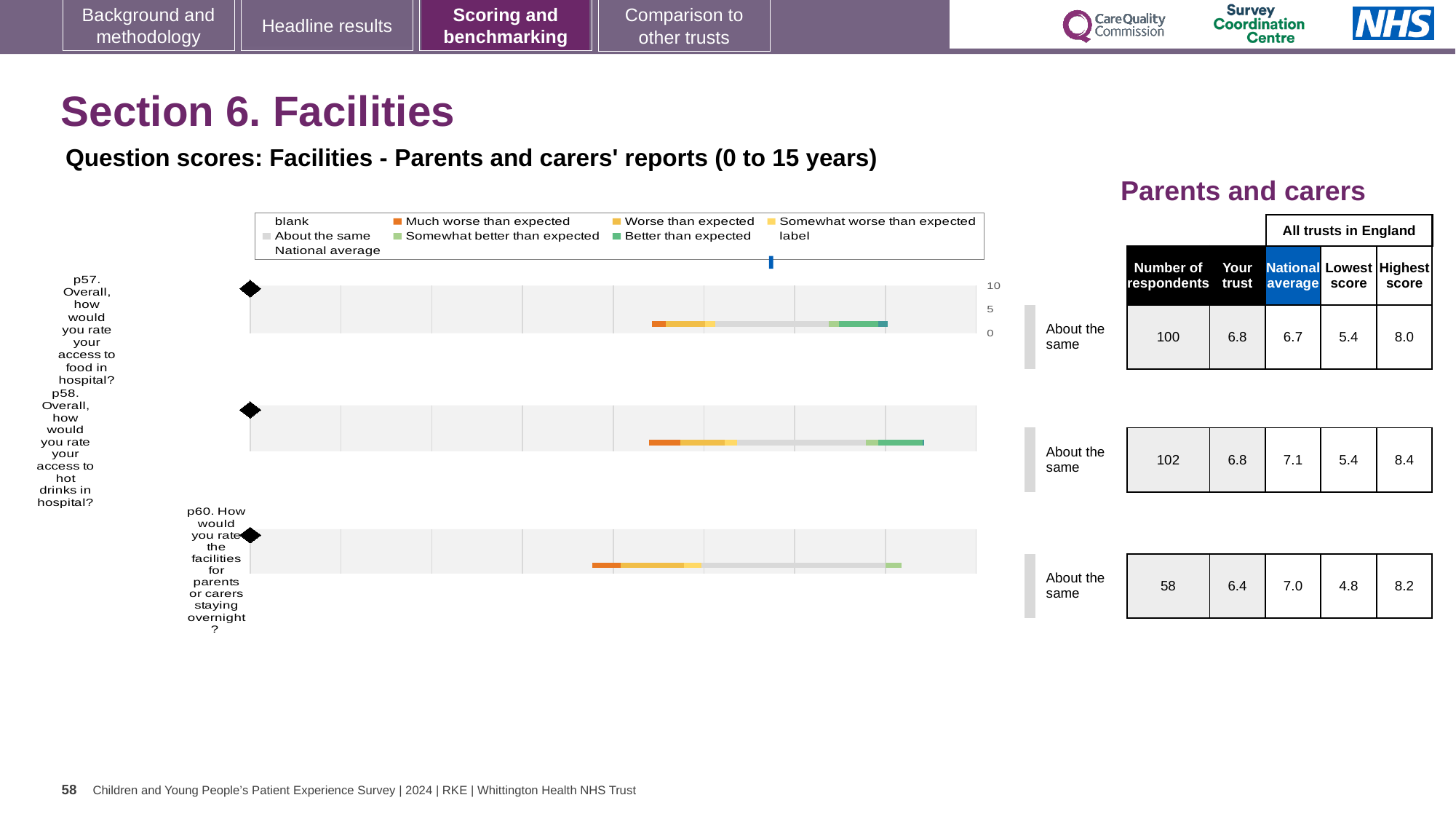
What is the highest score across all trusts in England for p58? 8.4 Which question has the highest number of respondents? p58 For p60, which is larger: the 'Your trust' score or the national average? National average What is the subtitle above the charts describing the question scores? Question scores: Facilities - Parents and carers' reports (0 to 15 years) Which question has the lowest 'Your trust' score? p60 What is the difference between the national average (7.0) and the 'Your trust' score (6.4) for p60? 0.6 What is the national average score for p58 (access to hot drinks in hospital)? 7.1 What kind of chart is used to show the question scores for p57, p58 and p60? bar chart How many questions (p57, p58, p60) are plotted as separate bars on the slide? 3 What is the 'Your trust' score for p57 (access to food in hospital)? 6.8 How many respondents answered p60 (facilities for parents or carers staying overnight)? 58 In the chart legend, which colour represents 'Better than expected'? green